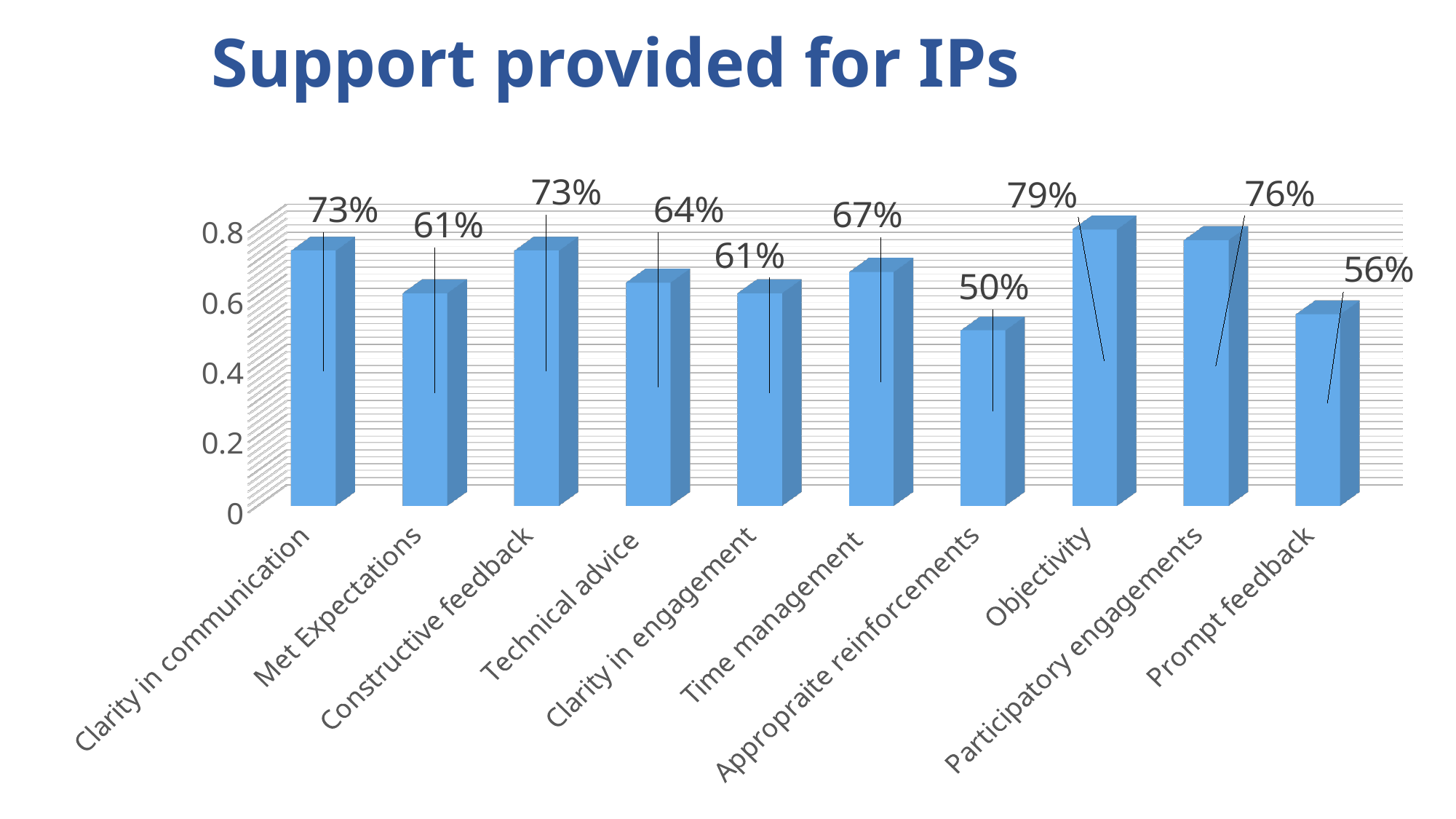
What is the title of the chart? Support provided for IPs What is the value for Prompt feedback? 56% What is the difference between the values for Participatory engagements and Time management? 9% Which category has the lowest value? Appropraite reinforcements Which category has the highest value? Objectivity What is the value for Objectivity? 79% How many categories are shown on the x axis? 10 What is the difference between the values for Objectivity and Appropraite reinforcements? 29% What is the value for Technical advice? 64% What is the value for Appropraite reinforcements? 50% What kind of chart is shown on the slide? Bar chart Which is larger, the value for Met Expectations or the value for Time management? Time management